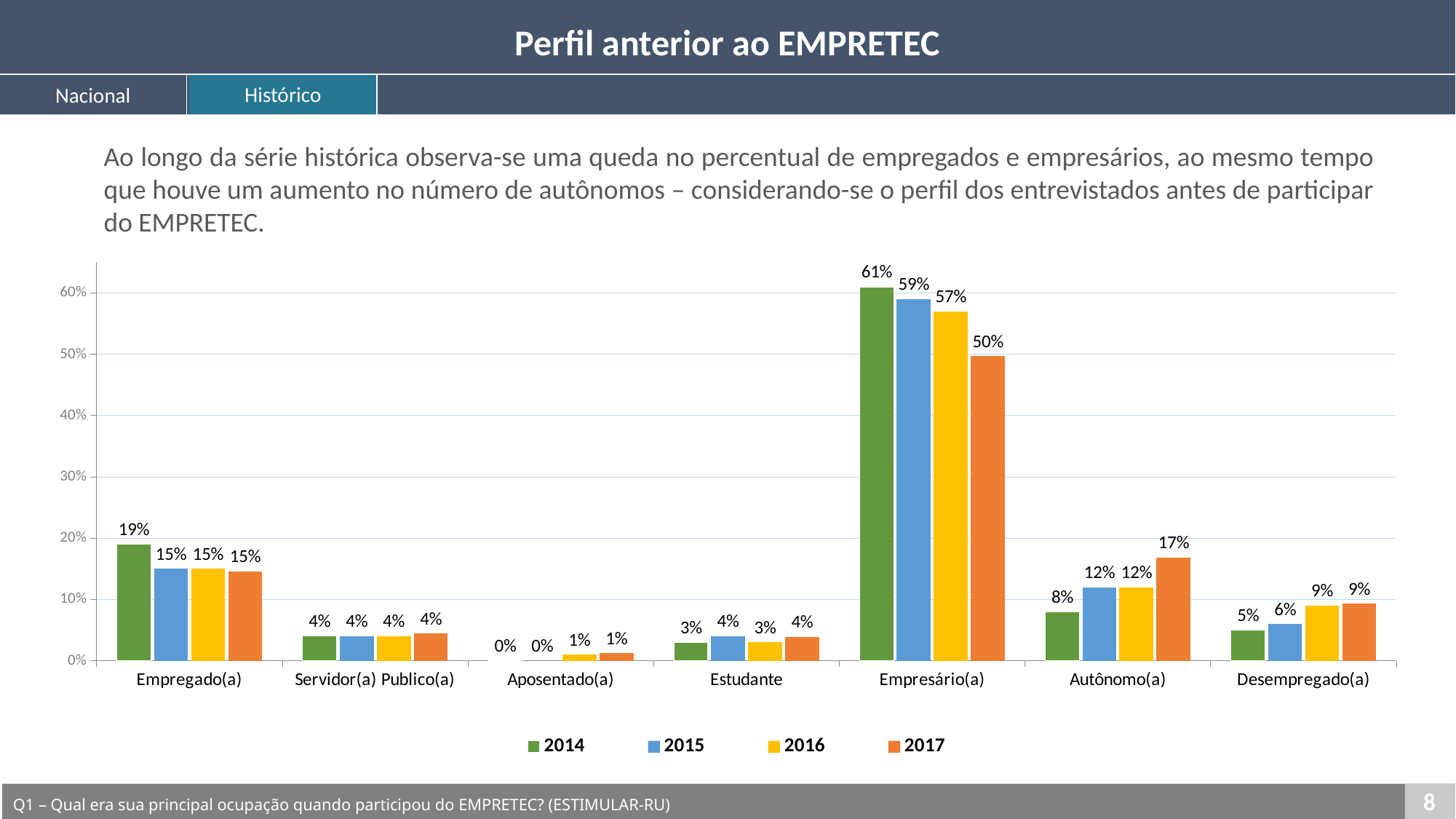
What is the value for Empresário(a) in 2014? 61% What is the value for Desempregado(a) in 2015? 6% What is the value for Autônomo(a) in 2017? 17% How many categories are shown on the x axis? 7 What kind of chart is shown on the slide? Bar chart Do the values for Empresário(a) rise or fall from 2014 to 2017? Fall Which category has the highest value in 2017? Empresário(a) Which is larger for Autônomo(a): the 2014 value or the 2017 value? 2017 What is the value for Empregado(a) in 2014? 19% Which category has the lowest value in 2014? Aposentado(a) What is the difference between the 2014 and 2017 values for Empresário(a)? 11% How many series does the legend list? 4